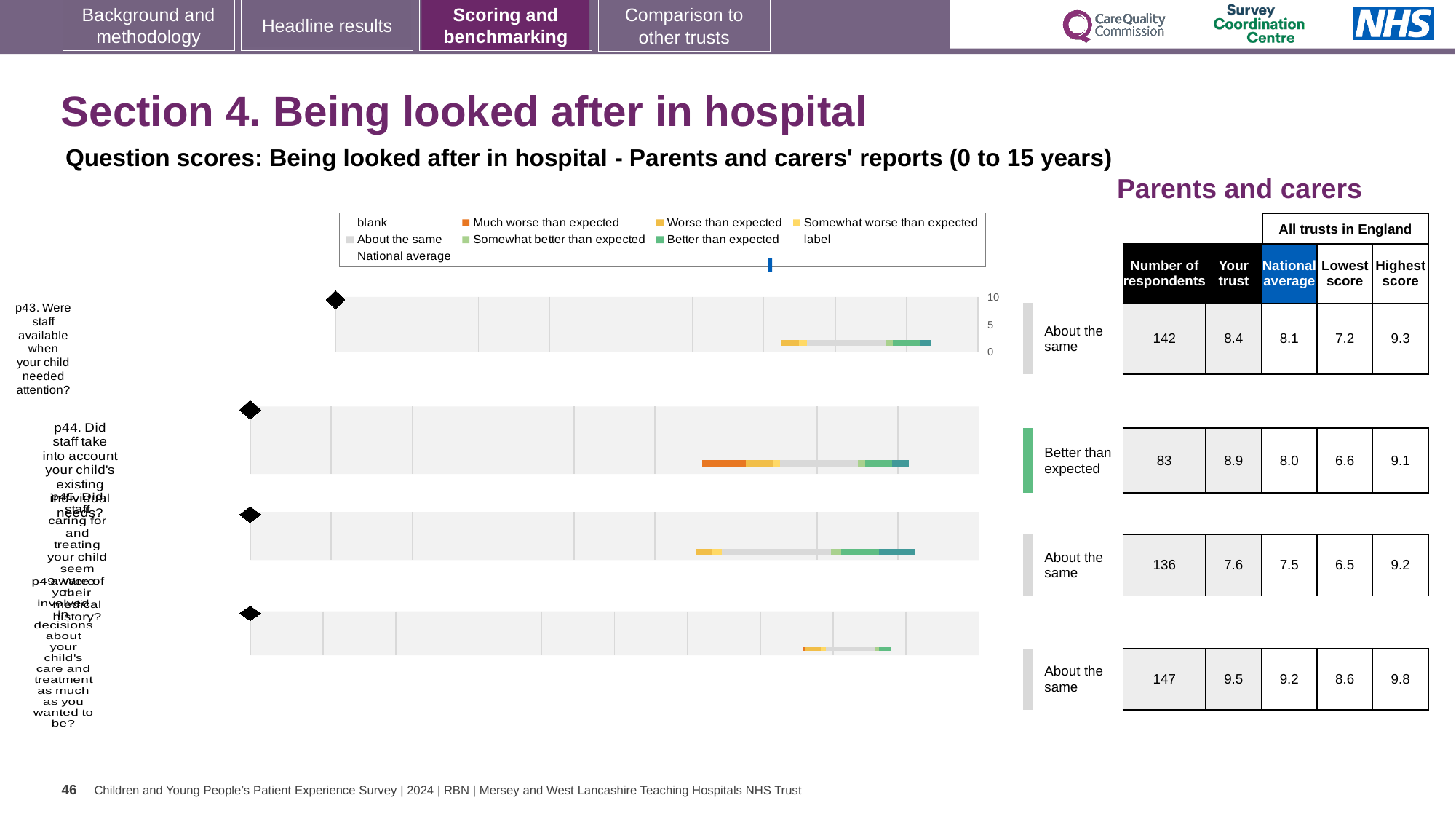
Which of the four charts is rated 'Better than expected' rather than 'About the same'? The second chart, p44 What is the national average score shown for the third chart (p45, staff seeming aware of your child's medical history)? 7.5 For the bottom chart (p49), which is larger: the 'Your trust' score or the national average? Your trust (9.5 vs 9.2) What is the 'Your trust' score shown for the second chart (p44, about taking into account your child's existing individual needs)? 8.9 What is the highest score across all trusts in England shown for the fourth (bottom) chart, p49? 9.8 What kind of chart is used for each question on this slide? Bar chart (stacked horizontal bars) How many question charts are shown on the slide? 4 What is the heading above the 'National average', 'Lowest score' and 'Highest score' columns in the table? All trusts in England Which of the four question charts has the lowest 'Your trust' score? The third chart, p45, with 7.6 In the table beside the charts, how many respondents are listed for the first (top) chart, p43 'Were staff available when your child needed attention?' 142 For the top chart (p43), what is the difference between the 'Your trust' score and the national average? 0.3 Which of the four question charts has the highest 'Your trust' score? The fourth (bottom) chart, p49, with 9.5